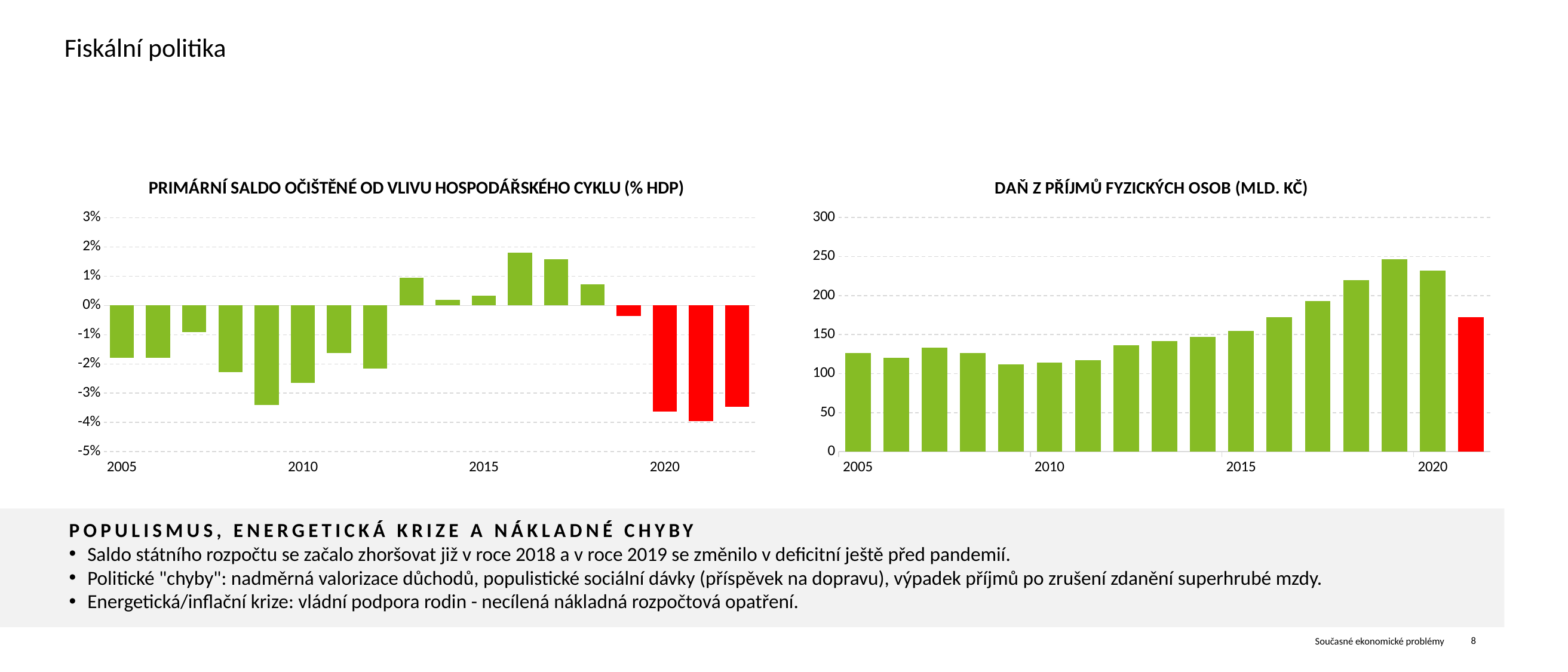
In the right chart (personal income tax), do the values rise or fall from 2015 to 2019? rise In the left chart (primary balance), which year has the lowest value? 2021 In the left chart (primary balance), is the value for 2009 greater or less than -3%? less In the left chart (primary balance), how many bars are shown in red? 4 What kind of chart is the left chart titled 'PRIMÁRNÍ SALDO OČIŠTĚNÉ OD VLIVU HOSPODÁŘSKÉHO CYKLU (% HDP)'? bar chart In the right chart (personal income tax), how many bars are plotted? 17 In the right chart (personal income tax), is the value for 2018 greater or less than 200? greater In the left chart (primary balance), which is larger, the value for 2005 or the value for 2009? 2005 In the right chart (personal income tax), which is larger, the value for 2020 or the value for 2021? 2020 In the left chart (primary balance), is the value for 2016 greater or less than 1%? greater In the right chart titled 'DAŇ Z PŘÍJMŮ FYZICKÝCH OSOB (MLD. KČ)', which year has the highest value? 2019